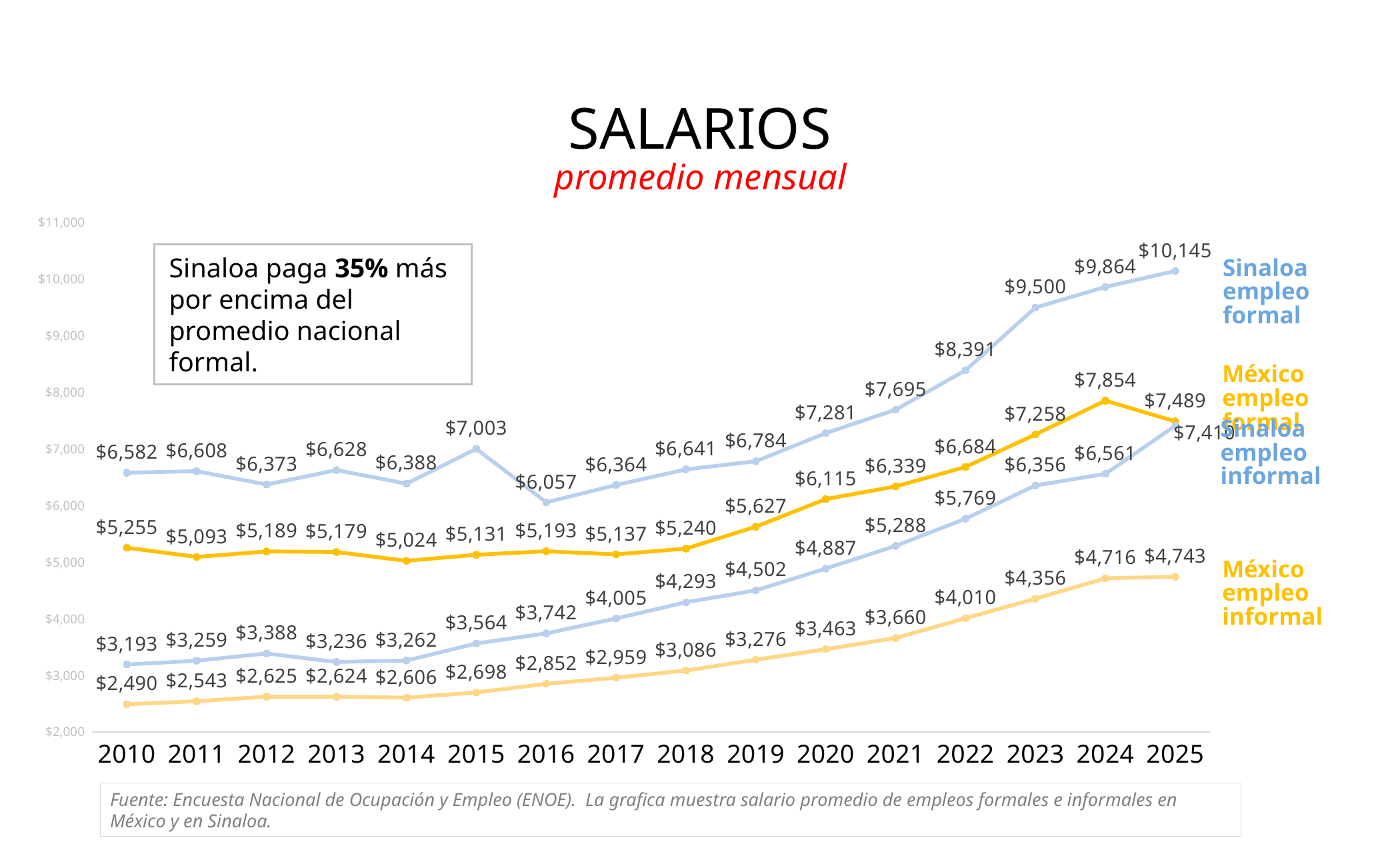
What is the value for México empleo informal in 2010? $2,490 What is the value for Sinaloa empleo formal in 2025? $10,145 How many years are shown on the x axis? 16 What is the value for Sinaloa empleo informal in 2020? $4,887 What type of chart is shown on the slide? line chart Does the México empleo informal series rise or fall from 2010 to 2025? rise In which year is the México empleo formal value highest? 2024 How many series does the chart show? 4 What is the value for México empleo formal in 2024? $7,854 Which is larger in 2023: Sinaloa empleo informal or México empleo formal? México empleo formal What is the difference between Sinaloa empleo formal and México empleo formal in 2025? $2,656 In which year is the Sinaloa empleo formal value lowest? 2016